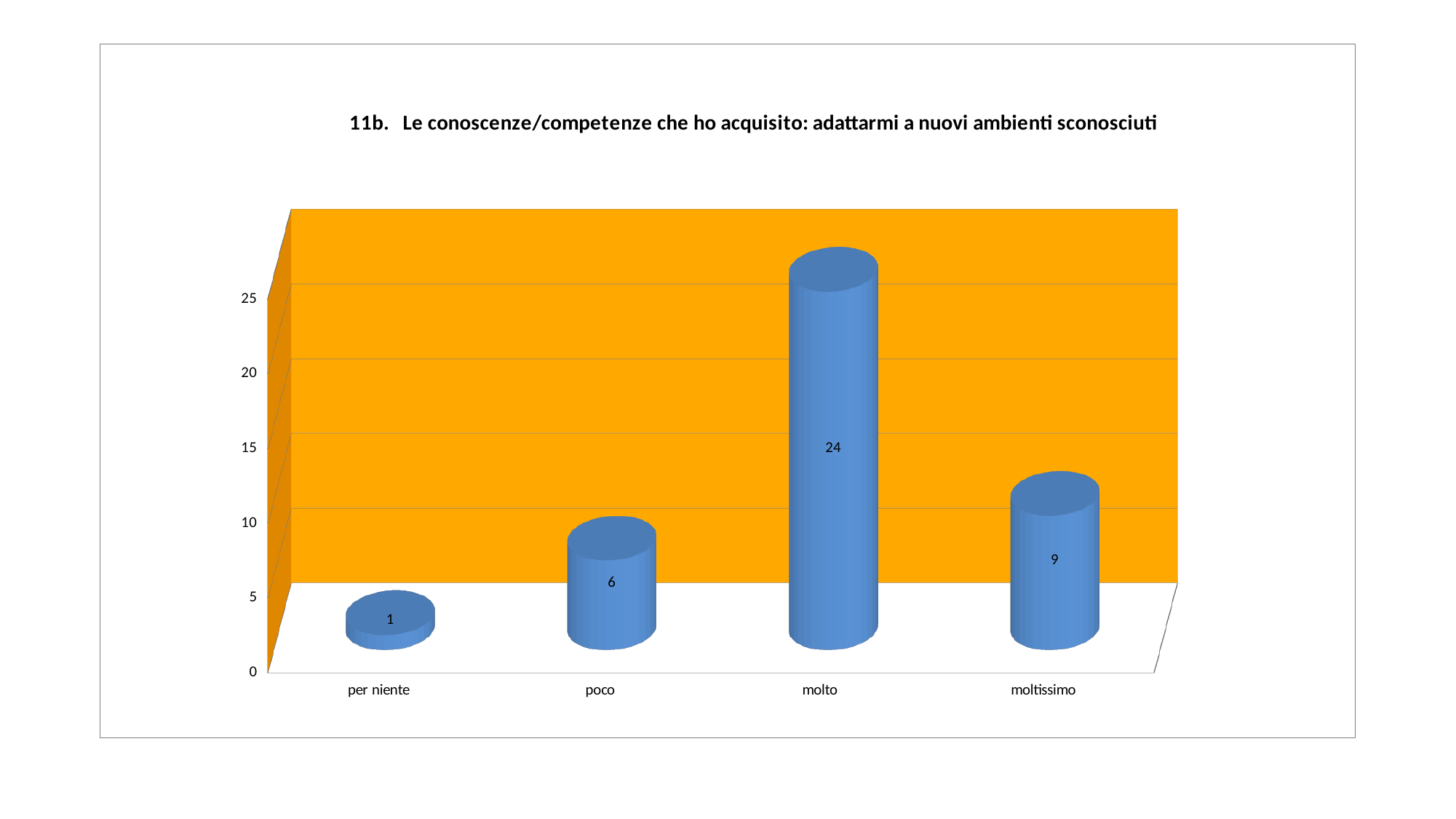
What is the title of the chart? 11b. Le conoscenze/competenze che ho acquisito: adattarmi a nuovi ambienti sconosciuti What is the value for "molto"? 24 How many categories are shown on the x axis? 4 Is the value for "molto" greater or less than 20? greater Which category has the lowest value? per niente Which is larger, the value for "poco" or the value for "moltissimo"? moltissimo What is the value for "poco"? 6 Which category has the highest value? molto What is the value for "moltissimo"? 9 What is the value for "per niente"? 1 What kind of chart is shown on the slide? bar chart What is the difference between the values for "molto" and "moltissimo"? 15